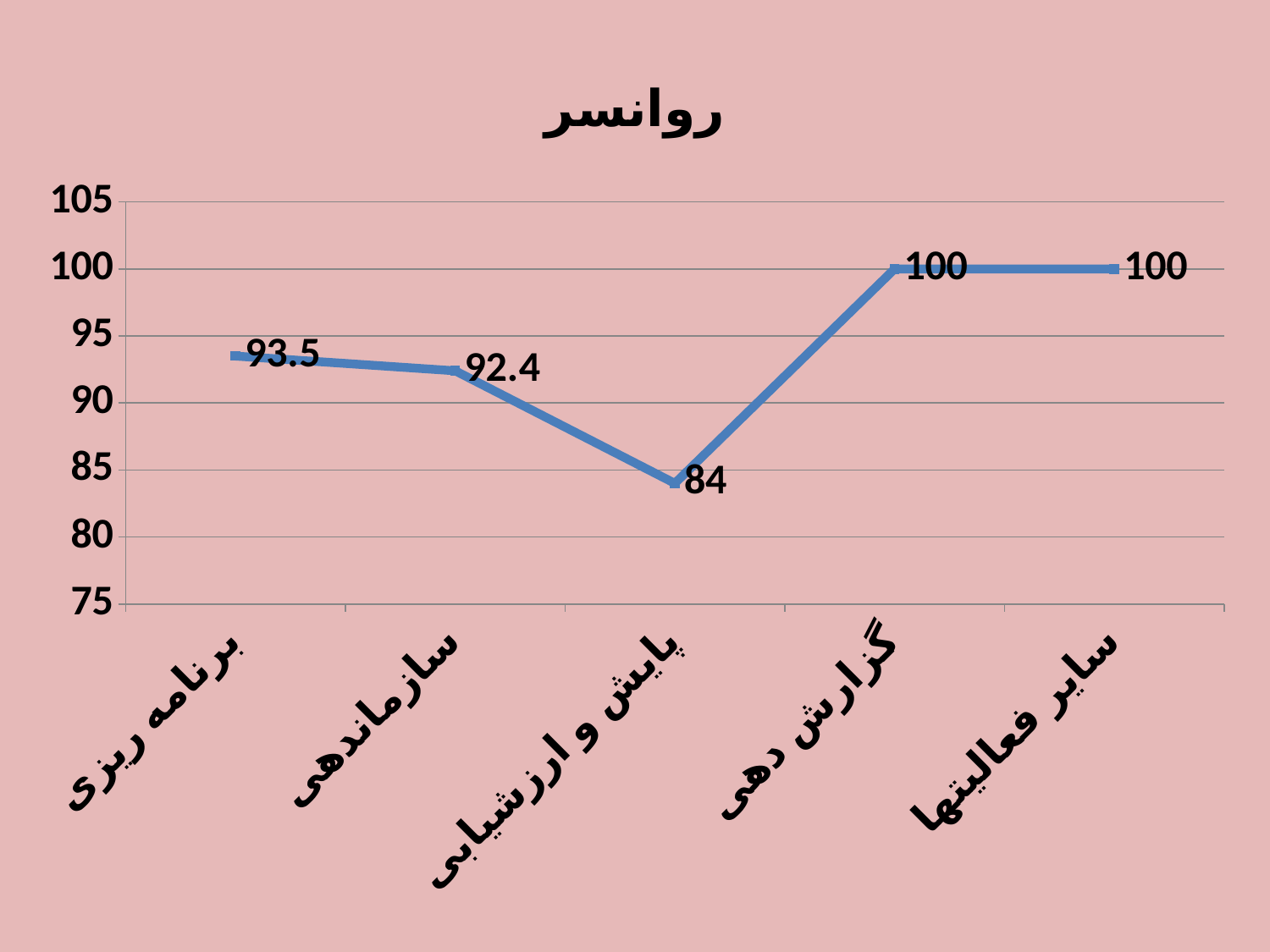
Which is larger, the value for برنامه ریزی or the value for پایش و ارزشیابی? برنامه ریزی What is the value for سازماندهی? 92.4 Which two categories share the highest value of 100? گزارش دهی and سایر فعالیتها What is the title of the chart? روانسر What is the value for گزارش دهی? 100 What is the difference between the values for برنامه ریزی and سازماندهی? 1.1 Which category has the lowest value? پایش و ارزشیابی What is the difference between the values for گزارش دهی and پایش و ارزشیابی? 16 What is the value for برنامه ریزی? 93.5 How many categories are plotted on the x axis? 5 What kind of chart is shown on the slide? Line chart What is the value for پایش و ارزشیابی? 84